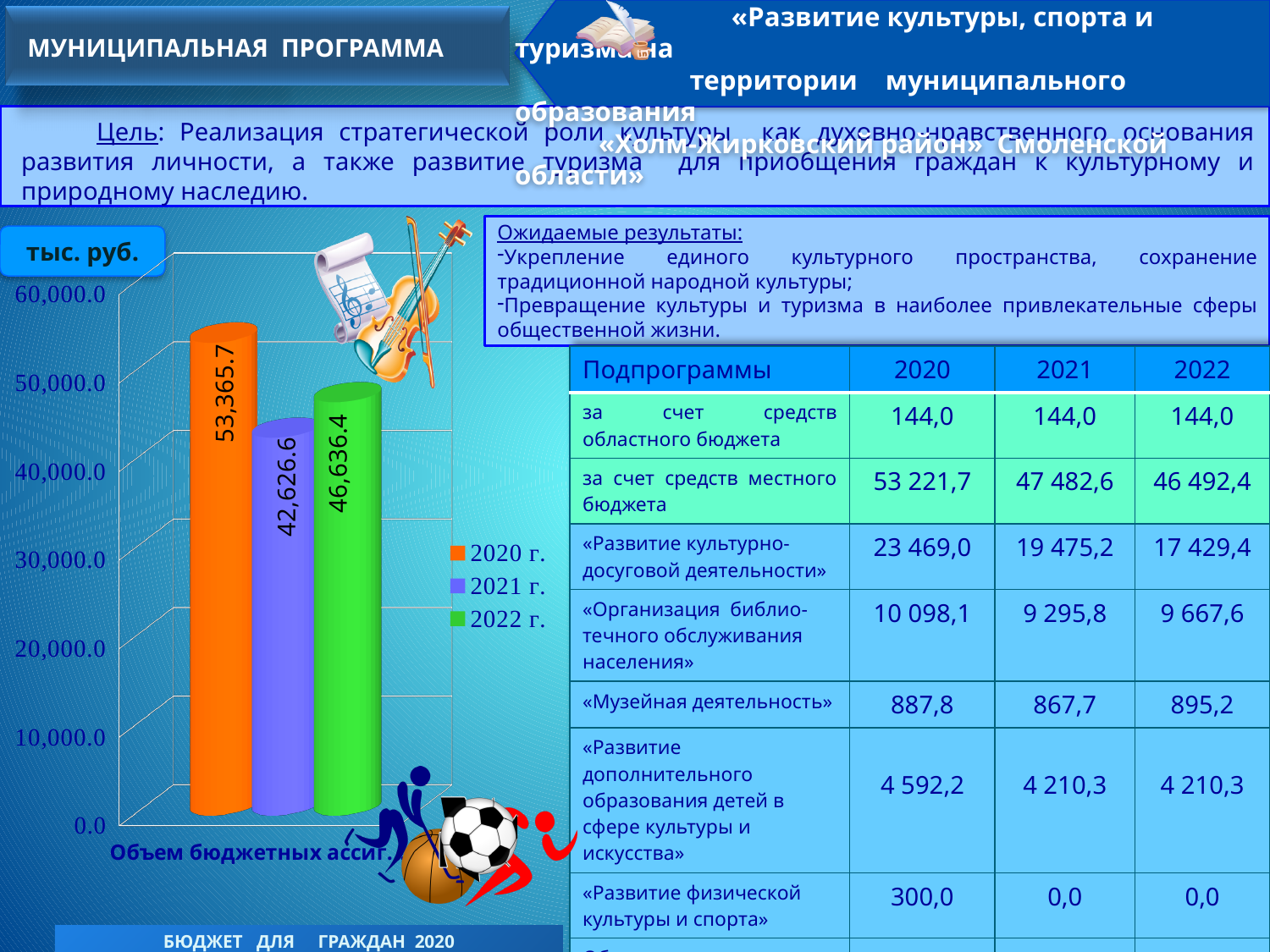
Which year has the highest bar in the chart? 2020 г. Which year has the lowest bar in the chart? 2021 г. Which is larger in the chart, the 2022 г. value or the 2021 г. value? 2022 г. What is the value of the 2020 г. bar in the chart? 53,365.7 What is the difference between the 2020 г. and 2021 г. values in the chart? 10,739.1 What is the value of the 2022 г. bar in the chart? 46,636.4 What is the difference between the 2022 г. and 2021 г. values in the chart? 4,009.8 What kind of chart is shown on the slide? bar chart Is the value for 2020 г. greater or less than 50,000.0? greater What unit is indicated for the chart values? тыс. руб. What is the value of the 2021 г. bar in the chart? 42,626.6 How many series does the chart legend list? 3